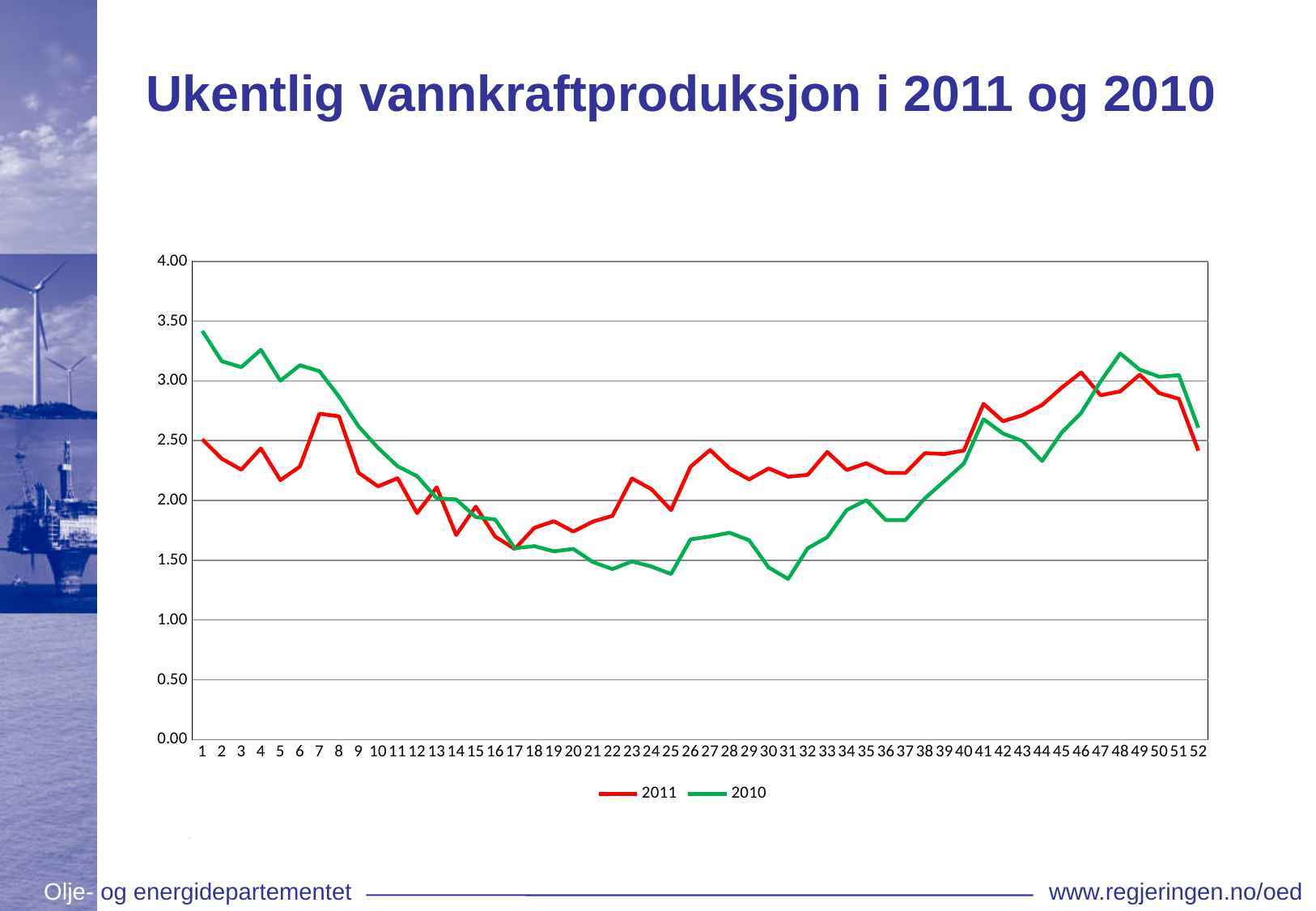
Does the 2010 series rise or fall from week 1 to week 17? Fall What kind of chart is shown on the slide? Line chart In which week does the 2010 series reach its highest value? Week 1 How many weeks are plotted along the x axis? 52 How many series does the legend list? 2 Is the value for 2010 in week 1 greater or less than 3.00? greater What is the title of the chart? Ukentlig vannkraftproduksjon i 2011 og 2010 In week 1, which series has the higher value, 2011 or 2010? 2010 Is the value for 2011 in week 17 greater or less than 2.00? less In week 31, which series has the higher value, 2011 or 2010? 2011 Is the value for 2010 in week 48 greater or less than 3.00? greater